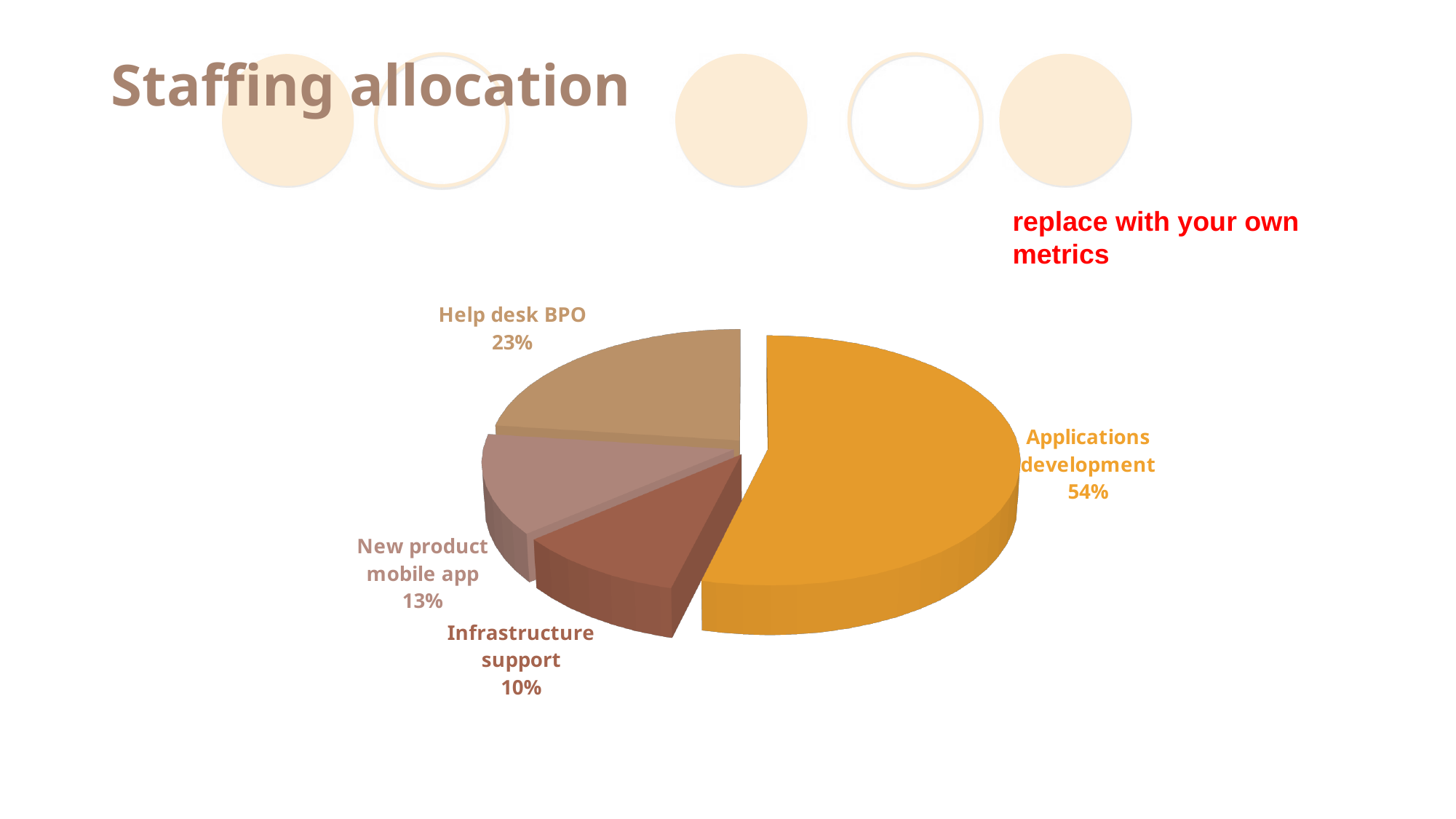
What share of staffing is allocated to Infrastructure support? 10% Which has a larger share, Help desk BPO or New product mobile app? Help desk BPO What share of staffing is allocated to Help desk BPO? 23% What share of staffing is allocated to New product mobile app? 13% What share of staffing is allocated to Applications development? 54% Which category has the smallest share of the pie? Infrastructure support What is the difference in percentage points between New product mobile app and Infrastructure support? 3 Which category has the largest share of the pie? Applications development What is the title of the slide containing the chart? Staffing allocation What is the difference in percentage points between Applications development and Help desk BPO? 31 What kind of chart is shown on the slide? Pie chart How many categories are shown in the pie chart? 4